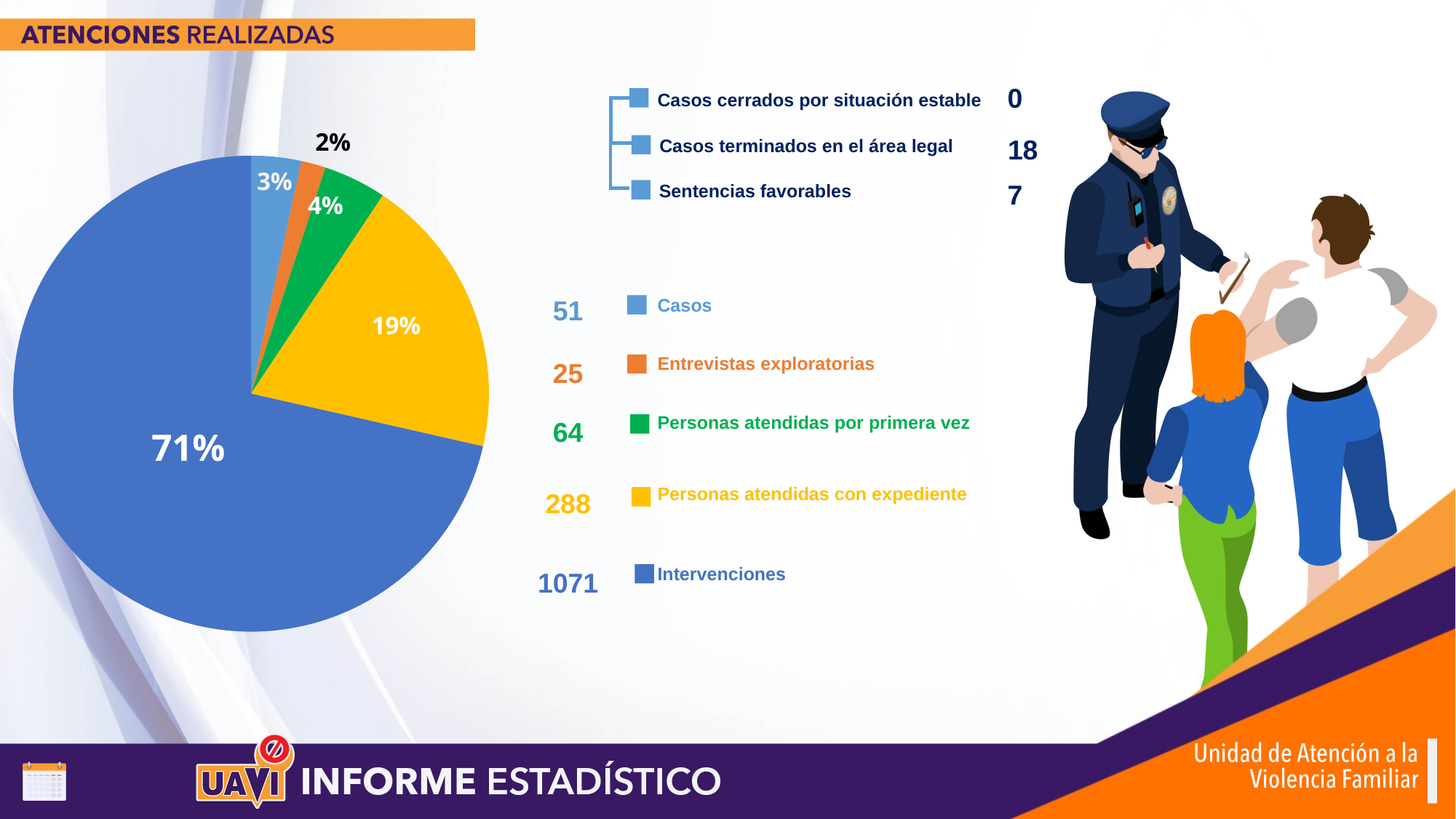
What is the difference between the values for Personas atendidas con expediente and Casos? 237 What colour is the slice for Personas atendidas con expediente? yellow What percentage of the pie does Entrevistas exploratorias represent? 2% What percentage of the pie does Personas atendidas con expediente represent? 19% What percentage of the pie does Intervenciones represent? 71% How many slices does the pie chart have? 5 What is the value listed for Personas atendidas por primera vez? 64 Which category has the largest slice of the pie? Intervenciones Which is larger, the value for Casos or the value for Entrevistas exploratorias? Casos What is the value listed for Intervenciones? 1071 What kind of chart is shown on the slide? pie chart Which category has the smallest slice of the pie? Entrevistas exploratorias